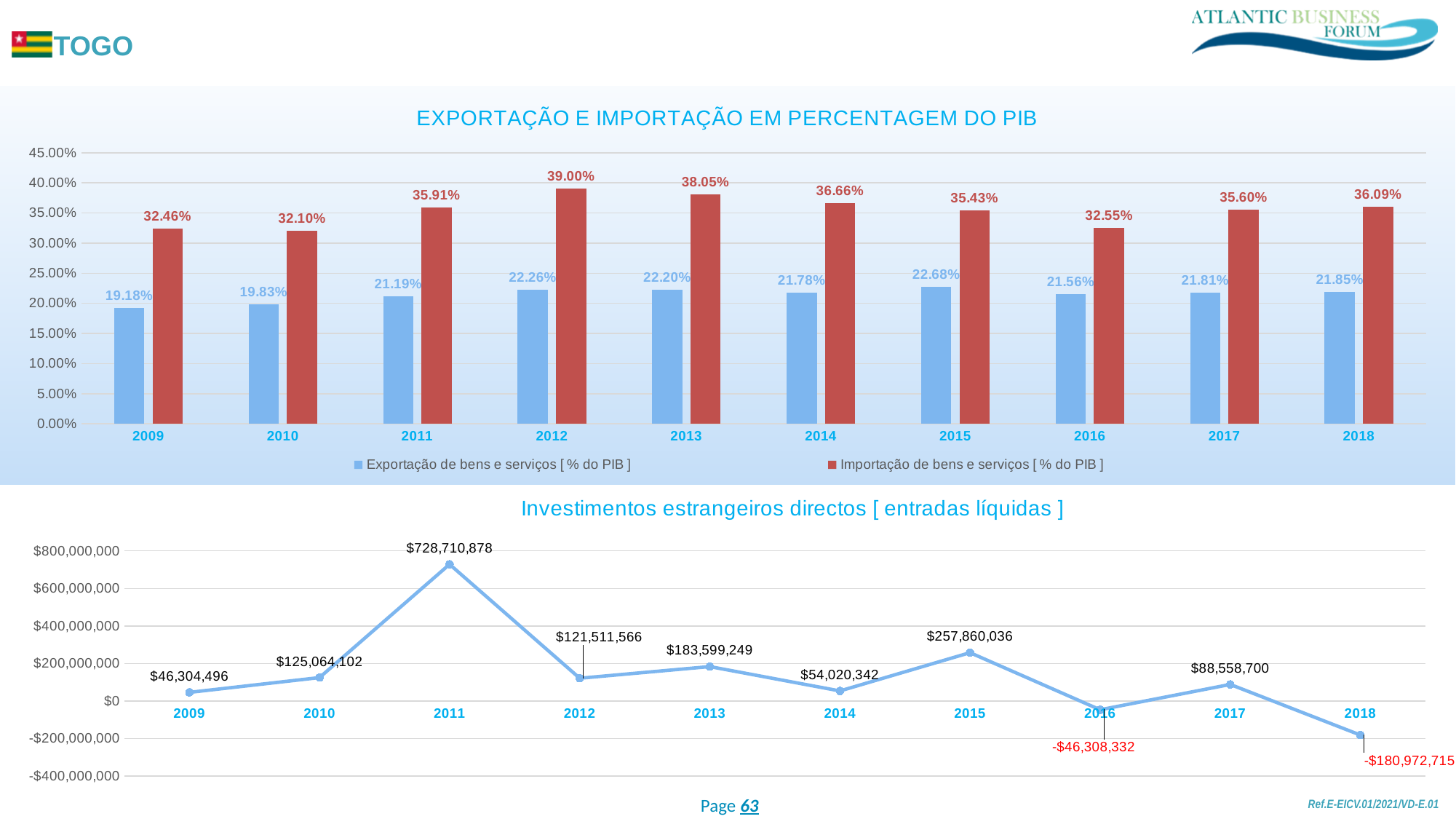
In the chart titled 'EXPORTAÇÃO E IMPORTAÇÃO EM PERCENTAGEM DO PIB', which year has the highest Exportação de bens e serviços value? 2015 In the chart titled 'EXPORTAÇÃO E IMPORTAÇÃO EM PERCENTAGEM DO PIB', which year has the lowest Importação de bens e serviços value? 2010 In the chart titled 'Investimentos estrangeiros directos [ entradas líquidas ]', which year has the lowest value? 2018 In the chart titled 'EXPORTAÇÃO E IMPORTAÇÃO EM PERCENTAGEM DO PIB', how many series does the legend list? 2 In the chart titled 'EXPORTAÇÃO E IMPORTAÇÃO EM PERCENTAGEM DO PIB', what is the difference between Importação and Exportação in 2018? 14.24% What kind of chart is the chart titled 'EXPORTAÇÃO E IMPORTAÇÃO EM PERCENTAGEM DO PIB'? Bar chart In the chart titled 'EXPORTAÇÃO E IMPORTAÇÃO EM PERCENTAGEM DO PIB', what is the value of Importação de bens e serviços in 2012? 39.00% In the chart titled 'Investimentos estrangeiros directos [ entradas líquidas ]', what is the value for 2018? -$180,972,715 In the chart titled 'Investimentos estrangeiros directos [ entradas líquidas ]', which is larger, the value for 2013 or the value for 2015? 2015 In the chart titled 'Investimentos estrangeiros directos [ entradas líquidas ]', what is the value for 2011? $728,710,878 In the chart titled 'Investimentos estrangeiros directos [ entradas líquidas ]', how many years are plotted? 10 In the chart titled 'EXPORTAÇÃO E IMPORTAÇÃO EM PERCENTAGEM DO PIB', what is the value of Exportação de bens e serviços in 2009? 19.18%